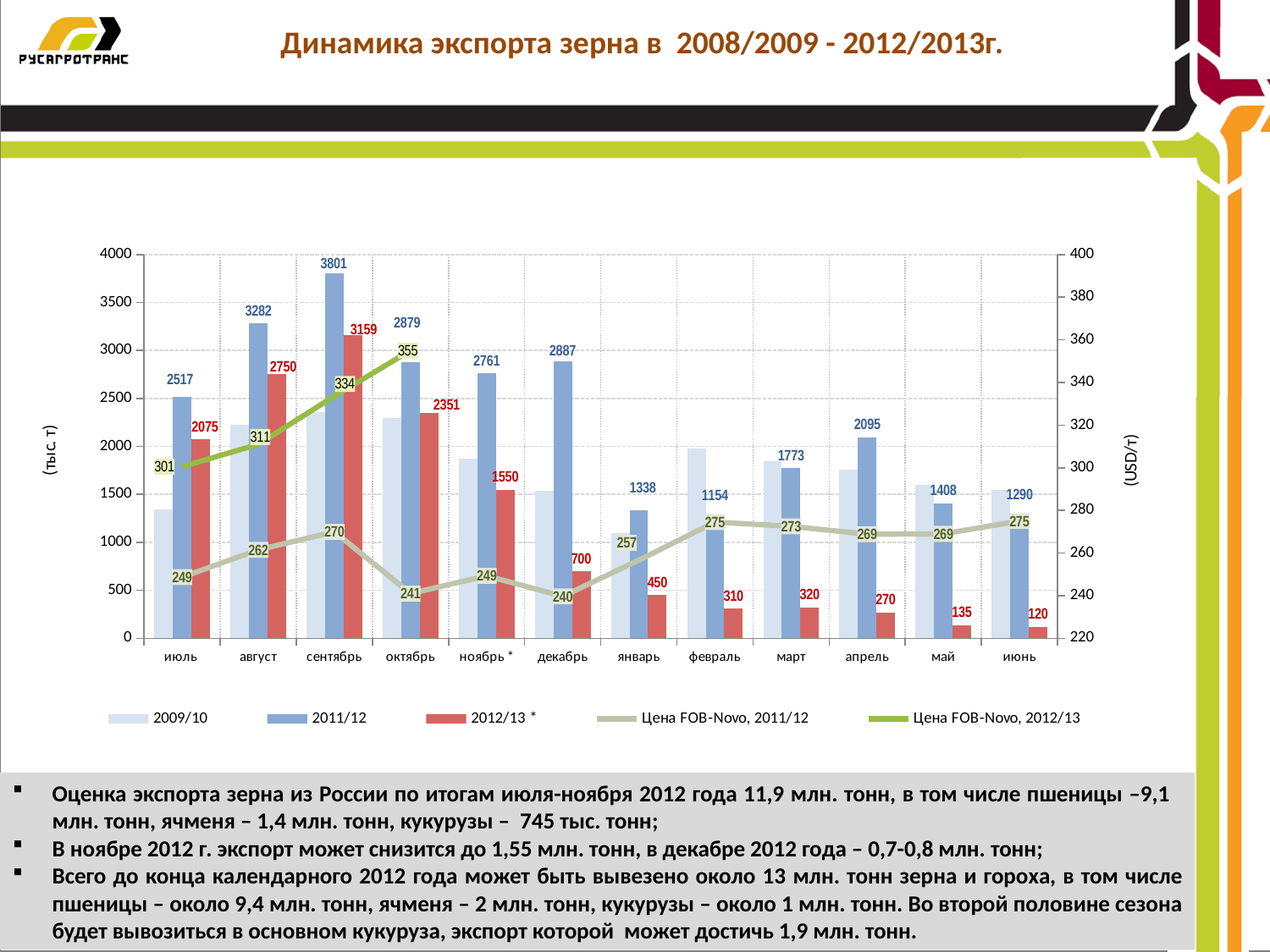
What is the 2012/13 * export value for ноябрь *? 1550 What is the Цена FOB-Novo, 2012/13 value for октябрь? 355 What kind of chart is shown on the slide? Combined bar and line chart Which month has the highest 2011/12 export value? сентябрь Is the 2009/10 value for февраль greater or less than 1500? greater What is the difference between the 2011/12 and 2012/13 * values for август? 532 How many months are shown on the x axis? 12 Does the Цена FOB-Novo, 2012/13 line rise or fall from июль to октябрь? rise How many series does the legend list? 5 Which is larger for декабрь: the 2011/12 value or the 2012/13 * value? 2011/12 Which month has the lowest 2012/13 * export value? июнь What is the 2011/12 export value for сентябрь? 3801